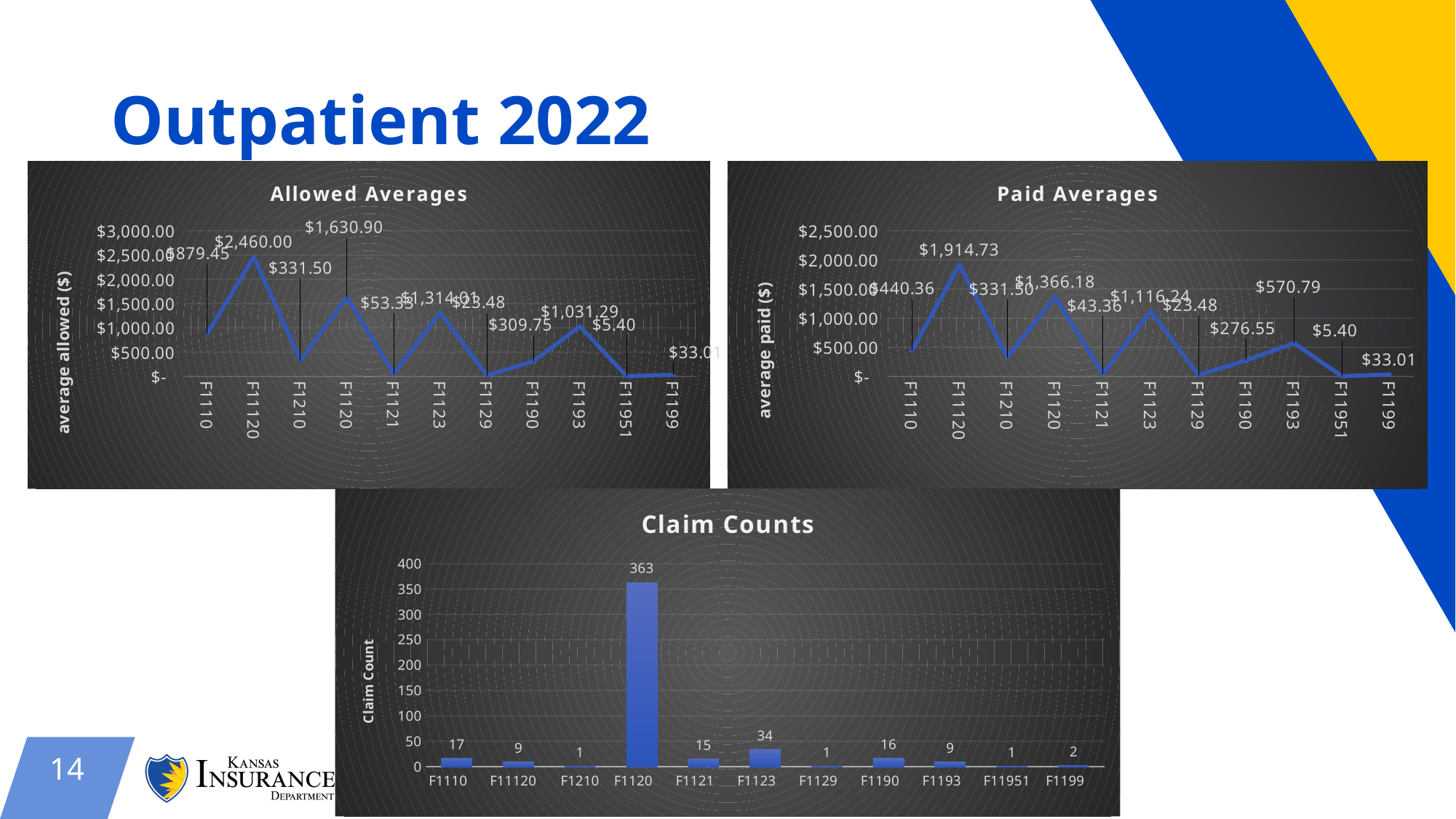
What kind of chart is the Allowed Averages chart? line chart In the Paid Averages chart, is the value for F1120 greater or less than $1,000.00? greater In the Paid Averages chart, what is the value for F1193? $570.79 What kind of chart is the Claim Counts chart? bar chart In the Allowed Averages chart, what is the value for F11120? $2,460.00 In the Allowed Averages chart, which is larger, the value for F1120 or the value for F1123? F1120 In the Claim Counts chart, what is the claim count for F1120? 363 In the Paid Averages chart, which category has the highest average paid? F11120 In the Claim Counts chart, which category has the highest claim count? F1120 How many categories are shown on the x axis of the Claim Counts chart? 11 In the Paid Averages chart, what is the value for F11120? $1,914.73 In the Claim Counts chart, what is the difference between the claim counts for F1123 and F1110? 17